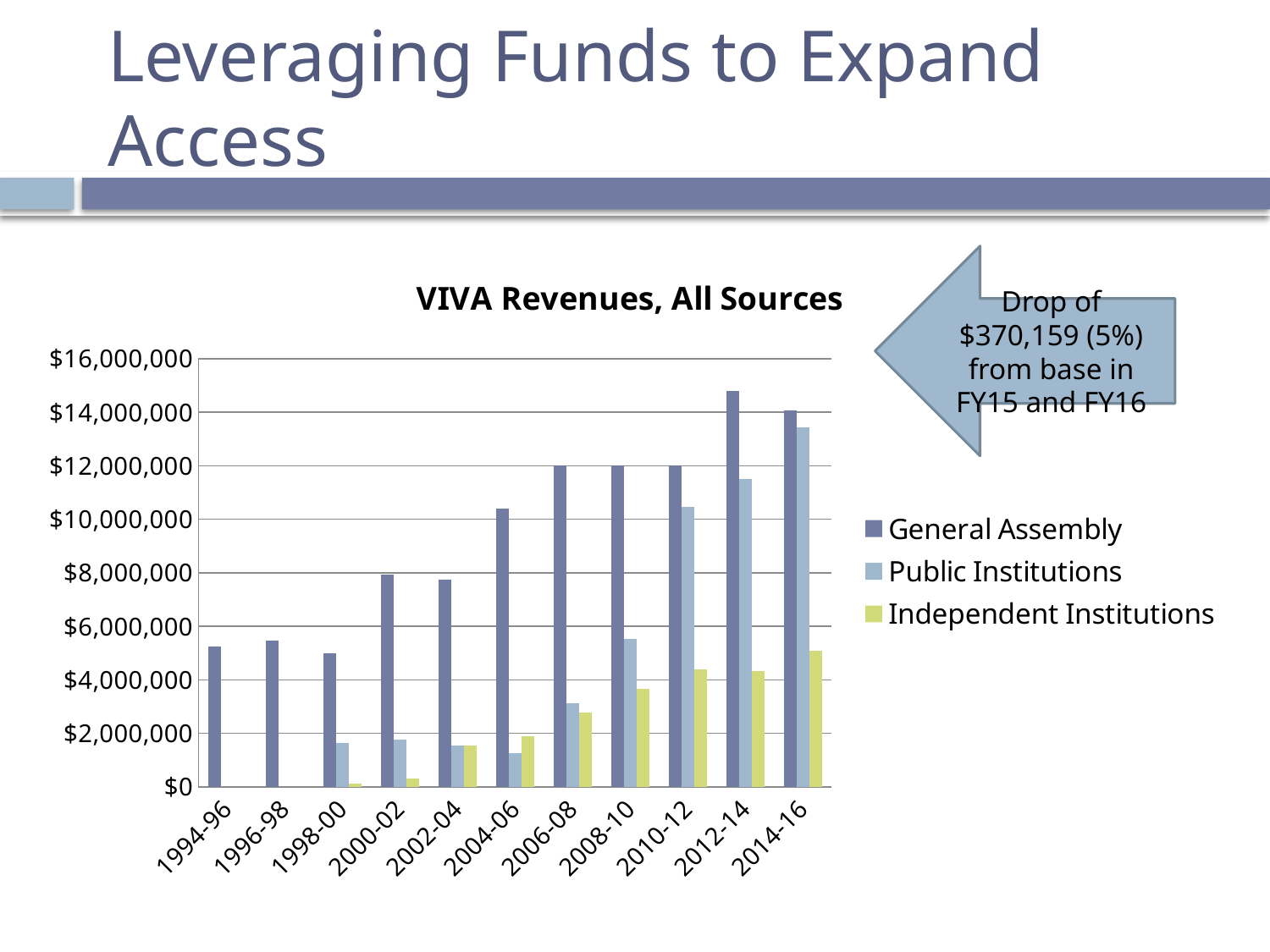
How many series does the chart's legend list? 3 What kind of chart is shown on the slide? Bar chart In which biennium is the Public Institutions revenue highest? 2014-16 How many biennium categories are shown on the x axis? 11 Which is larger in 2010-12: General Assembly or Public Institutions revenue? General Assembly Is the General Assembly value for 2012-14 greater or less than $14,000,000? greater Do Public Institutions revenues generally rise or fall from 2004-06 to 2014-16? Rise Which series is shown in yellow-green bars? Independent Institutions Is the Public Institutions value for 2008-10 greater or less than $6,000,000? less Is the Independent Institutions value for 2014-16 greater or less than $4,000,000? greater In which biennium is the General Assembly revenue highest? 2012-14 What is the title of the chart? VIVA Revenues, All Sources